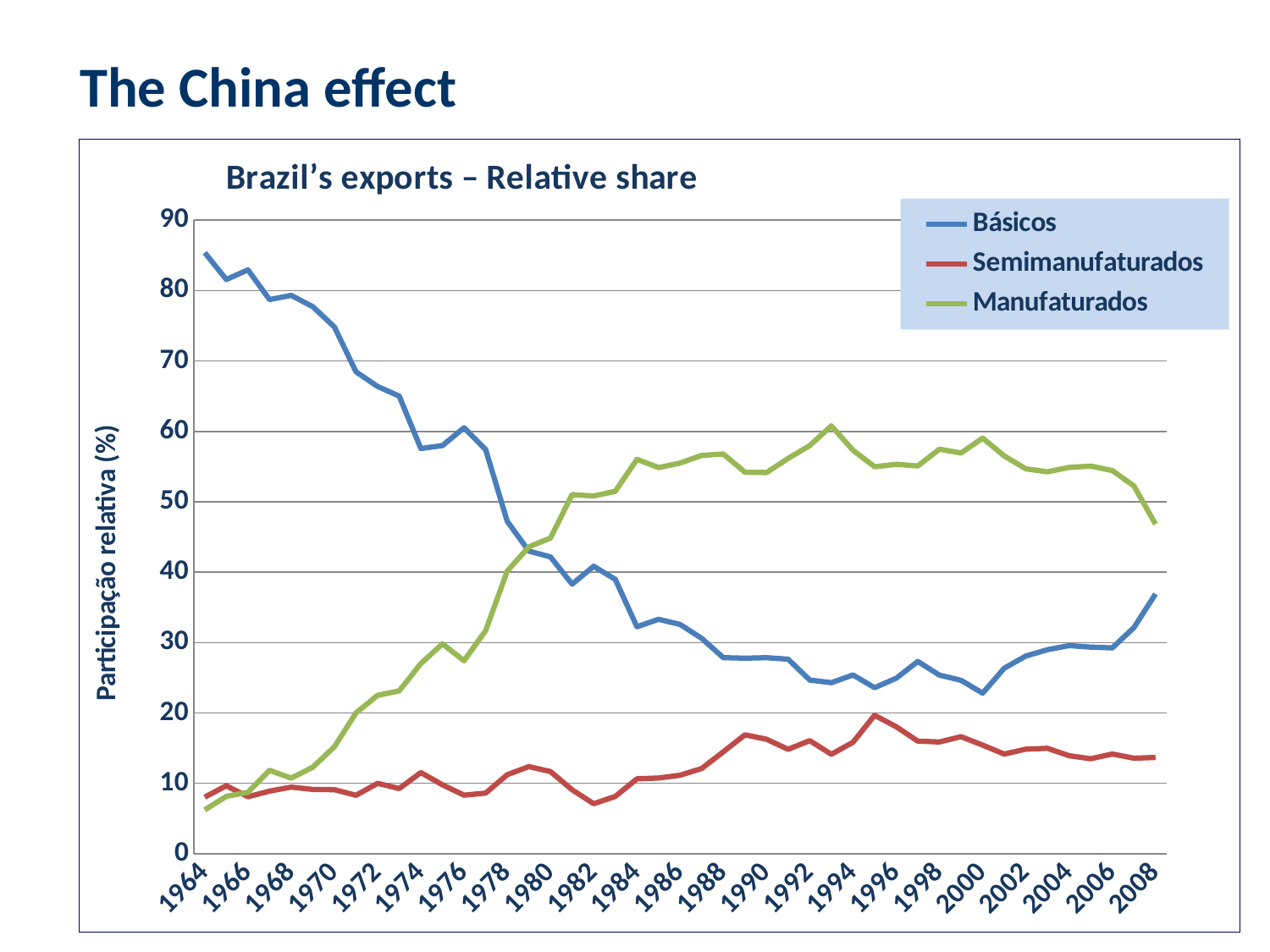
Which series has the lowest value in 2008? Semimanufaturados Is the value for Manufaturados in 1964 greater or less than 10? less Is the value for Básicos in 2000 greater or less than 30? less What kind of chart is shown on the slide? Line chart Does the Básicos series rise or fall between 1964 and 1980? Fall Is the value for Manufaturados in 2008 greater or less than 50? less Which series has the highest value in 1964? Básicos In 2008, which is larger: Manufaturados or Básicos? Manufaturados What is the title of the chart? Brazil's exports – Relative share What is the label of the vertical axis? Participação relativa (%) How many series does the legend list? 3